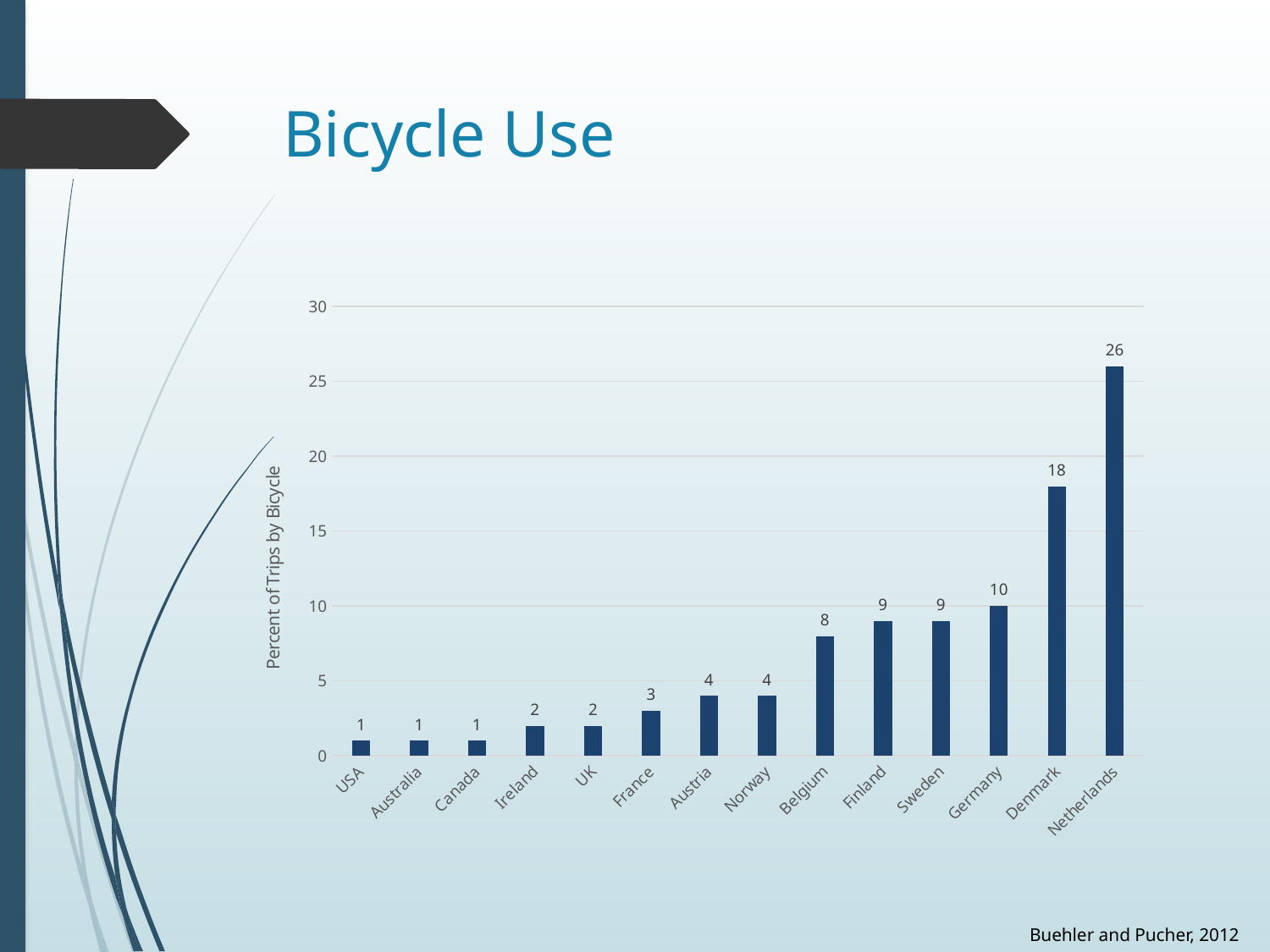
What is the value shown for Belgium? 8 Which country has the highest percent of trips by bicycle? Netherlands What kind of chart is shown on the slide? Bar chart Which has a larger value, Germany or Belgium? Germany Is the value for Denmark greater or less than 15? greater What is the percent of trips by bicycle for Denmark? 18 How many countries are shown on the x axis? 14 What is the label of the vertical axis? Percent of Trips by Bicycle Do the values generally rise or fall from left to right along the x axis? Rise What is the difference between the values for the Netherlands and Denmark? 8 What is the percent of trips by bicycle for the Netherlands? 26 What is the title of the slide? Bicycle Use